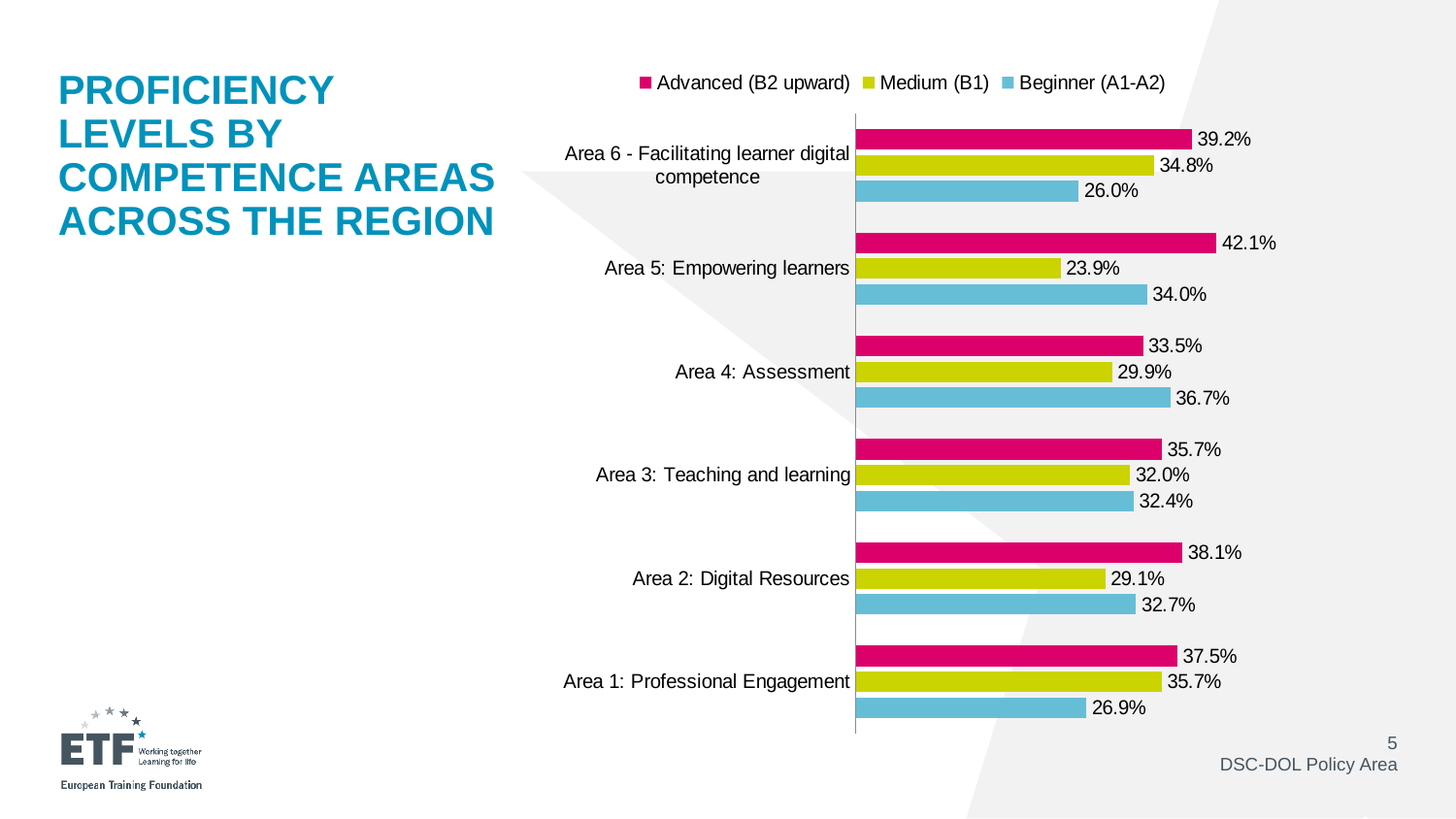
What is the difference between the Advanced (B2 upward) and Beginner (A1-A2) values for Area 6 - Facilitating learner digital competence? 13.2 percentage points What is the value for Medium (B1) in Area 1: Professional Engagement? 35.7% What is the value for Beginner (A1-A2) in Area 4: Assessment? 36.7% What kind of chart is shown on the slide? Bar chart How many series does the legend list? 3 What is the value for Advanced (B2 upward) in Area 5: Empowering learners? 42.1% Which competence area has the highest Beginner (A1-A2) value? Area 4: Assessment How many competence areas are shown on the chart? 6 Which competence area has the lowest Medium (B1) value? Area 5: Empowering learners What is the difference between the Advanced (B2 upward) and Medium (B1) values for Area 5: Empowering learners? 18.2 percentage points In Area 4: Assessment, which is larger, the Advanced (B2 upward) value or the Beginner (A1-A2) value? Beginner (A1-A2) Which competence area has the highest Advanced (B2 upward) value? Area 5: Empowering learners